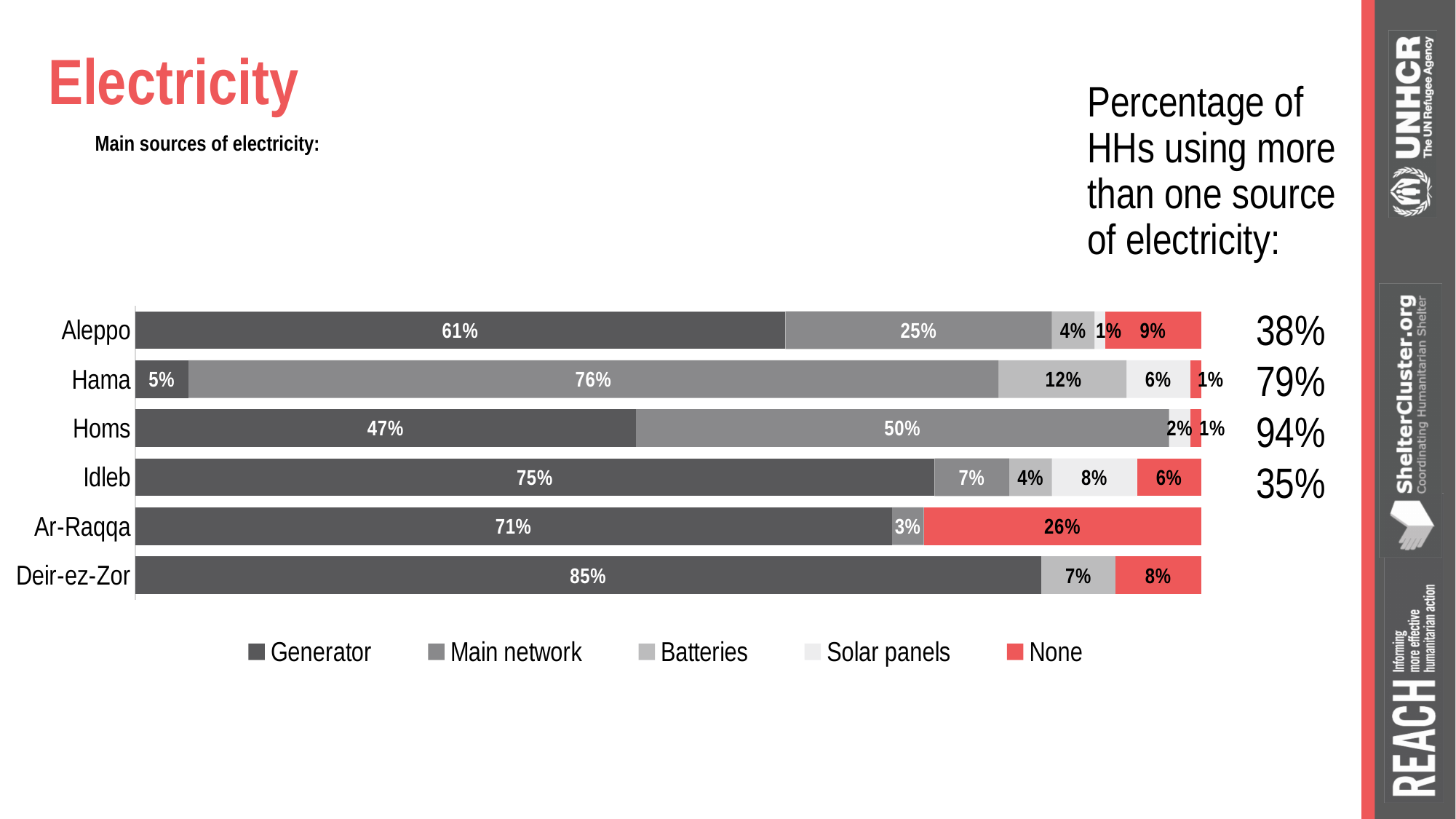
Which governorate has the highest Generator percentage? Deir-ez-Zor Which has a larger Main network percentage, Aleppo or Homs? Homs What is the difference in percentage points between the Generator values for Idleb and Homs? 28 percentage points How many series does the legend list? 5 Which governorate has the lowest Generator percentage? Hama What percentage of households in Aleppo use a generator as their main source of electricity? 61% Which governorate has the highest percentage of households with no source of electricity (None)? Ar-Raqqa What is the Main network value for Hama? 76% How many governorates are shown in the chart? 6 What percentage of households in Ar-Raqqa have no source of electricity (None)? 26% What is the Solar panels value for Idleb? 8% What type of chart is used to show the main sources of electricity? Stacked bar chart